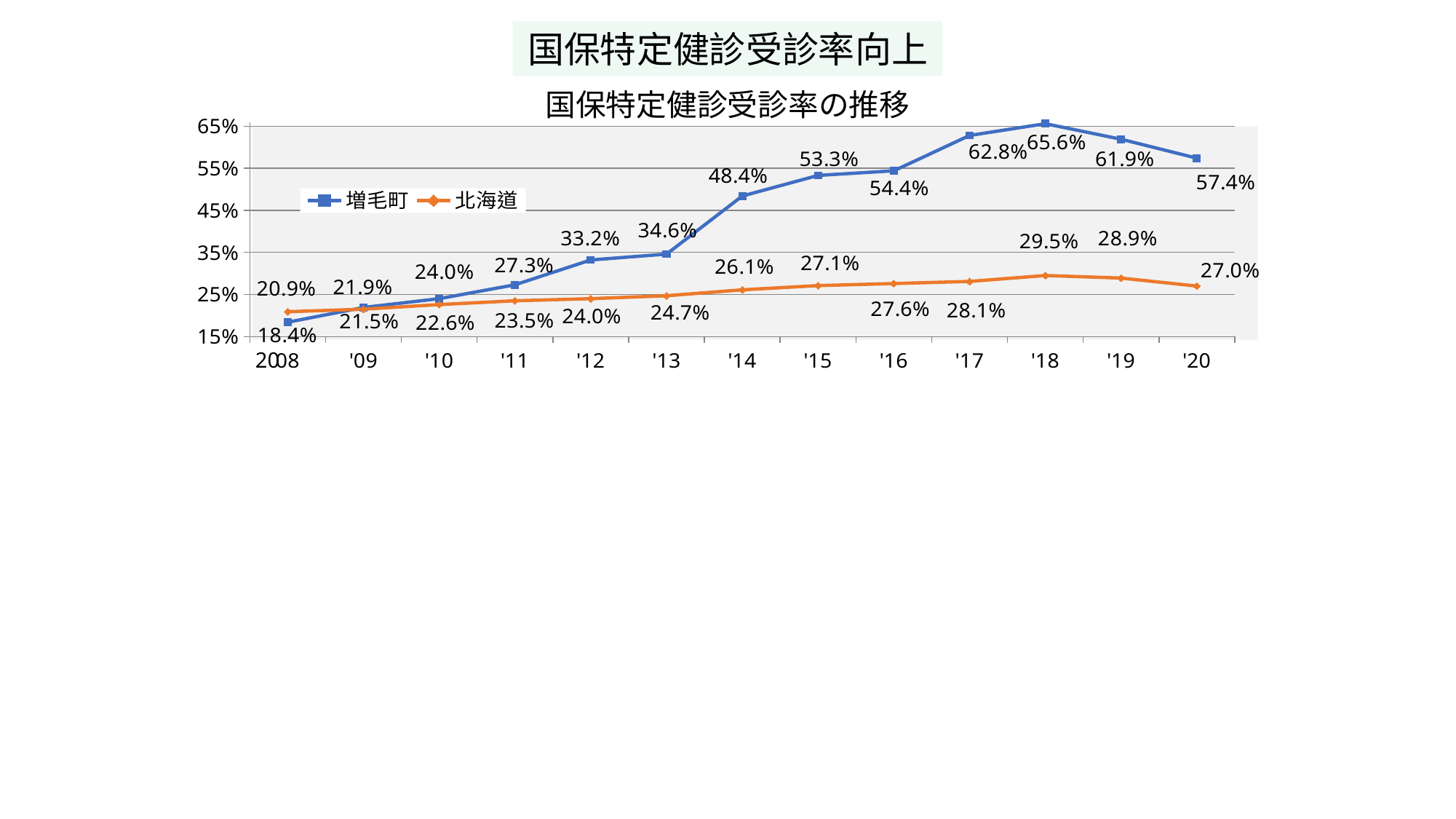
What type of chart is shown on the slide? line chart In which year does 増毛町 reach its highest value? '18 In which year is the 北海道 value lowest? 2008 How many series does the legend list? 2 What is the value for 北海道 in '14? 26.1% Does the 北海道 line generally rise or fall from 2008 to '18? rise What is the title of the chart? 国保特定健診受診率の推移 What is the value for 増毛町 in 2008? 18.4% How many years are plotted on the x axis? 13 What is the difference between 増毛町 and 北海道 in '20? 30.4% Which series has the higher value in 2008, 増毛町 or 北海道? 北海道 What is the value for 増毛町 in '18? 65.6%